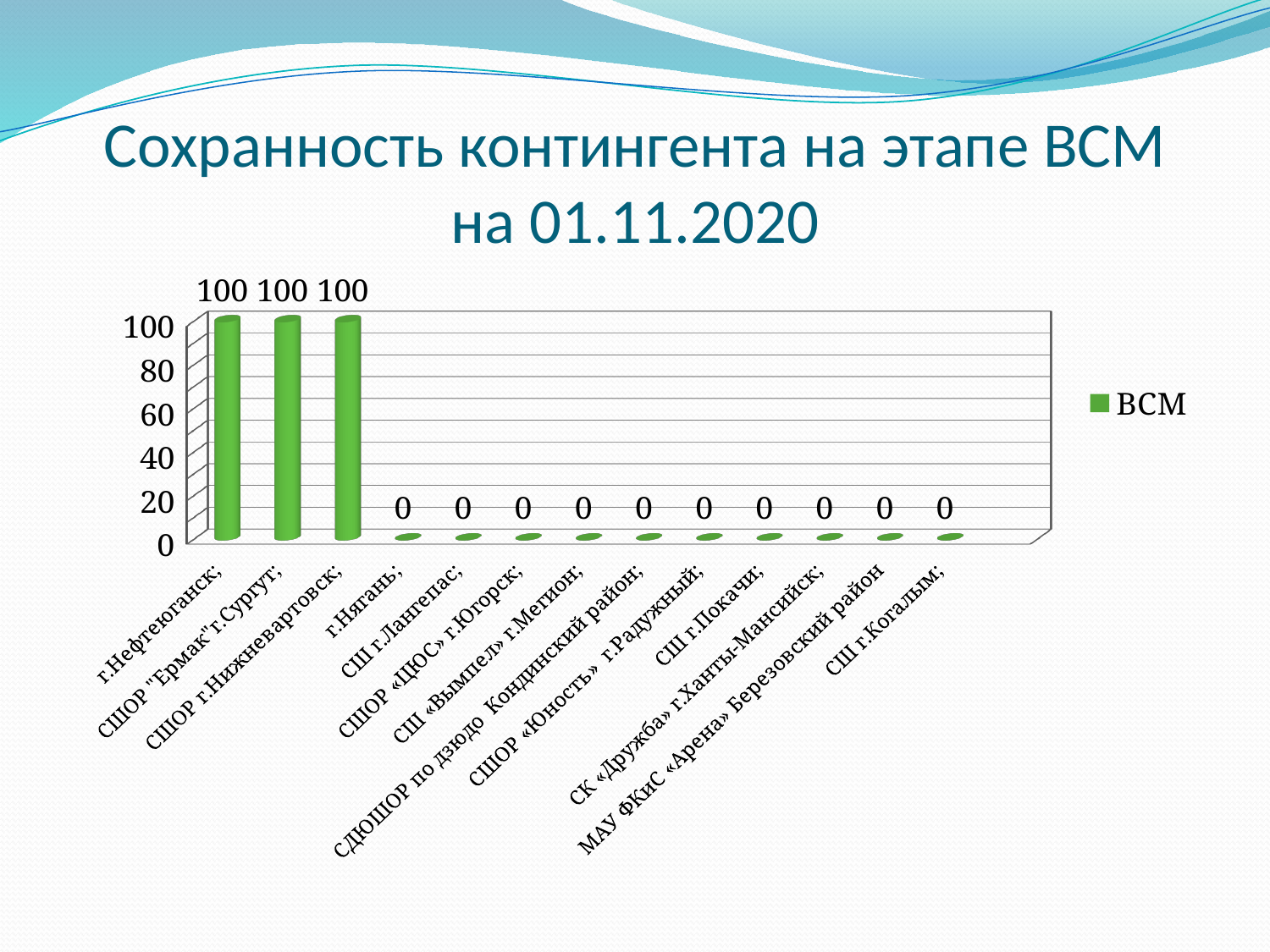
What is the value for СШОР "Ермак" г.Сургут? 100 What is the difference between the value for СШОР г.Нижневартовск and the value for СШ г.Покачи? 100 What is the value for СШ г.Лангепас? 0 What series name is shown in the legend? ВСМ What is the value for г.Нефтеюганск? 100 What is the value for СШОР г.Нижневартовск? 100 How many categories have a value of 100? 3 Which is larger, the value for г.Нефтеюганск or the value for г.Нягань? г.Нефтеюганск How many categories are shown on the x axis? 13 How many series does the legend list? 1 What is the value for СШ г.Когалым? 0 What kind of chart is shown on the slide? Bar chart